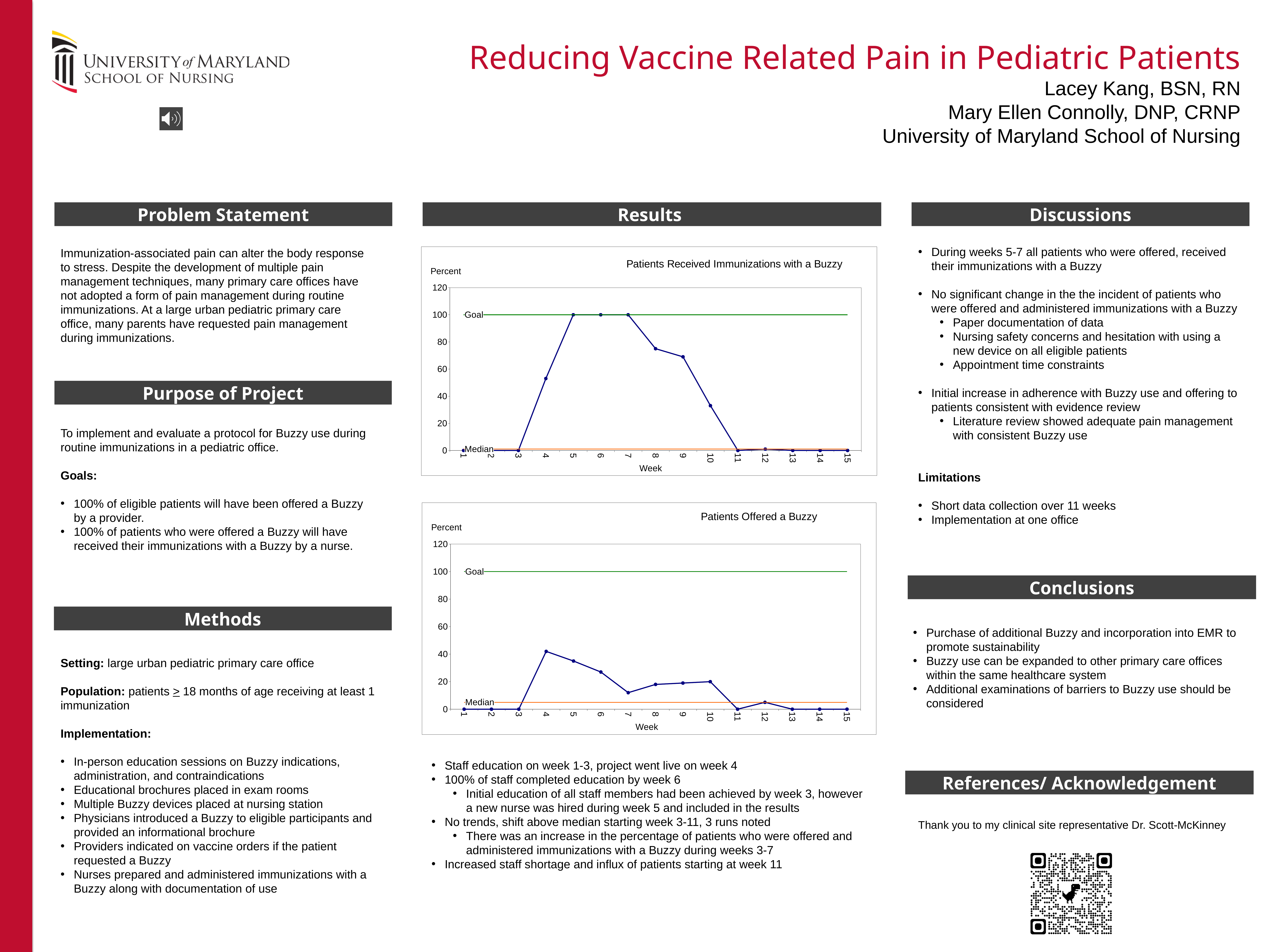
In the 'Patients Received Immunizations with a Buzzy' chart, what is the value for week 6? 100 In the 'Patients Received Immunizations with a Buzzy' chart, is the value for week 8 greater or less than 60? greater In the 'Patients Offered a Buzzy' chart, is the value for week 7 greater or less than 20? less In the 'Patients Received Immunizations with a Buzzy' chart, what is the value for week 13? 0 What kind of chart is the 'Patients Received Immunizations with a Buzzy' chart? line chart In the 'Patients Offered a Buzzy' chart, which week has the highest value? week 4 In the 'Patients Received Immunizations with a Buzzy' chart, is the value for week 10 greater or less than 40? less In the 'Patients Received Immunizations with a Buzzy' chart, how many weeks are shown on the x axis? 15 In the 'Patients Offered a Buzzy' chart, what is the label of the x axis? Week In the 'Patients Received Immunizations with a Buzzy' chart, which is larger, the value for week 8 or week 10? week 8 In the 'Patients Received Immunizations with a Buzzy' chart, at what value is the Goal line drawn? 100 In the 'Patients Offered a Buzzy' chart, do the values rise or fall from week 4 to week 7? fall